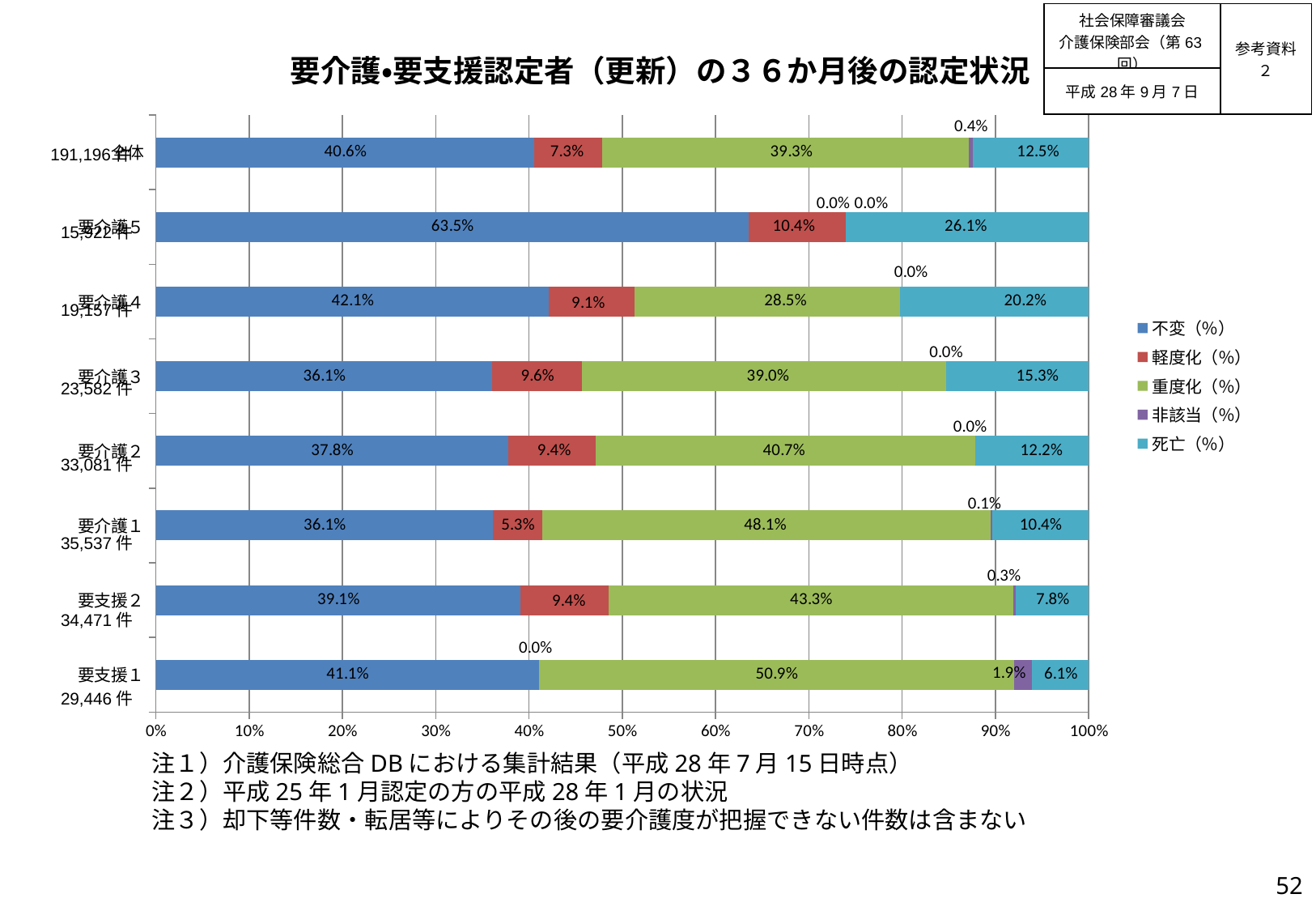
What is the difference between the 死亡（%） values for 要介護5 and 要介護4? 5.9% How many series does the legend list? 5 Which series is shown in green in the chart? 重度化（%） Which category has the lowest 死亡（%） value? 要支援1 What is the 死亡（%） value for 全体? 12.5% How many categories (bars) are plotted in the chart? 8 Which is larger, the 重度化（%） value for 要介護2 or for 要介護3? 要介護2 What type of chart is shown on the slide? stacked bar chart What is the 軽度化（%） value for 要介護1? 5.3% What is the 不変（%） value for 要介護5? 63.5% What is the 重度化（%） value for 要支援1? 50.9% Which category has the highest 不変（%） value? 要介護5